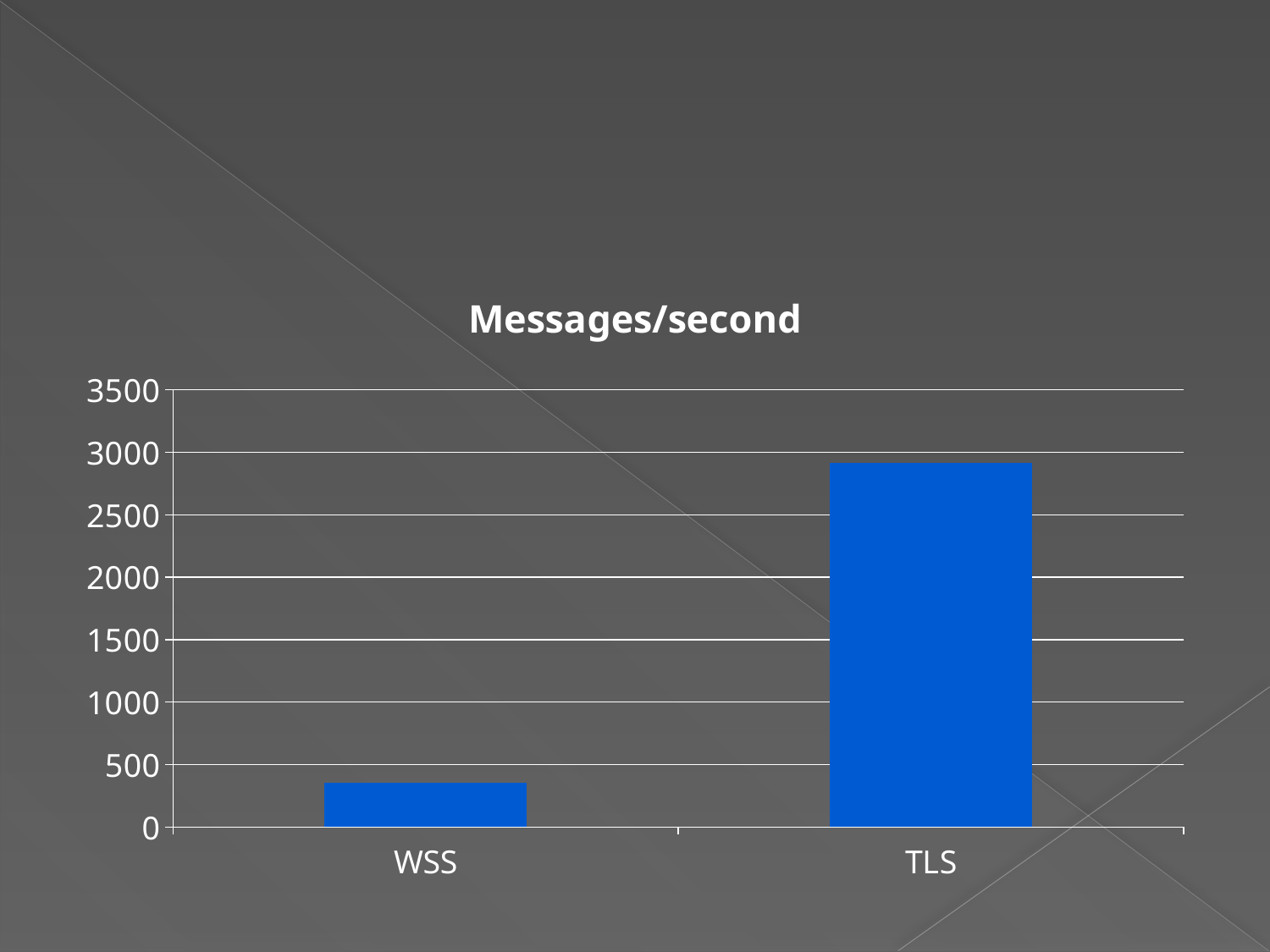
What is the title of the chart? Messages/second Which is larger, the value for WSS or the value for TLS? TLS Is the value for TLS greater or less than 2500? greater What kind of chart is shown on the slide? bar chart Which category has the highest value? TLS Which category has the lowest value? WSS How many categories are shown on the x axis? 2 What is the highest value shown on the y axis? 3500 Is the value for TLS greater or less than 3000? less Is the value for WSS greater or less than 500? less